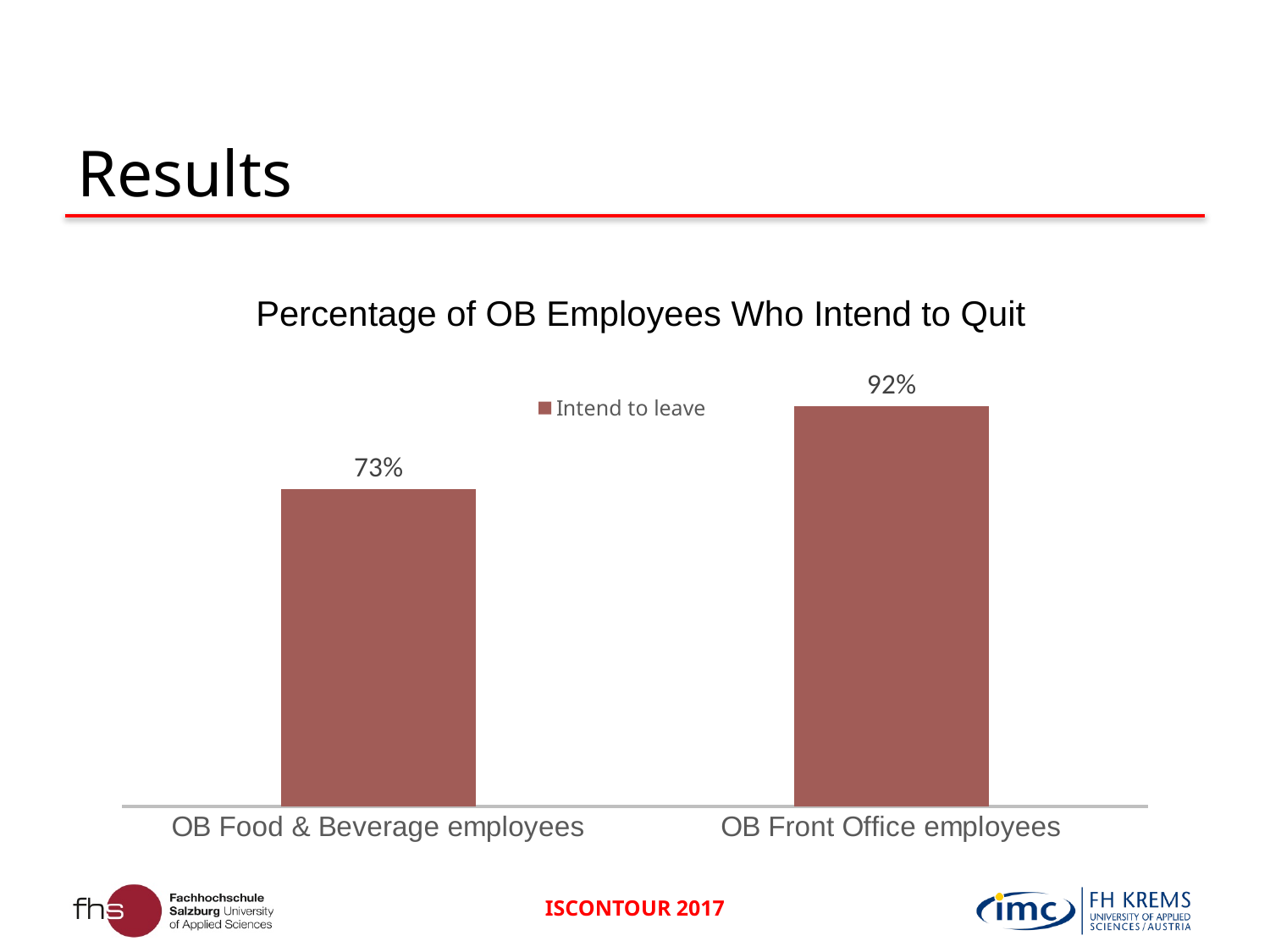
Do the values rise or fall from left to right across the categories? Rise Which is larger: the percentage for OB Food & Beverage employees or for OB Front Office employees? OB Front Office employees What percentage of OB Front Office employees intend to leave? 92% Which employee group has the lowest percentage intending to quit? OB Food & Beverage employees What is the difference in percentage points between OB Front Office employees and OB Food & Beverage employees who intend to leave? 19 How many series does the legend list? 1 What is the name of the series listed in the legend? Intend to leave Which employee group has the highest percentage intending to quit? OB Front Office employees How many employee groups are shown in the chart? 2 What kind of chart is shown on the slide? Bar chart What is the title of the chart? Percentage of OB Employees Who Intend to Quit What percentage of OB Food & Beverage employees intend to leave? 73%